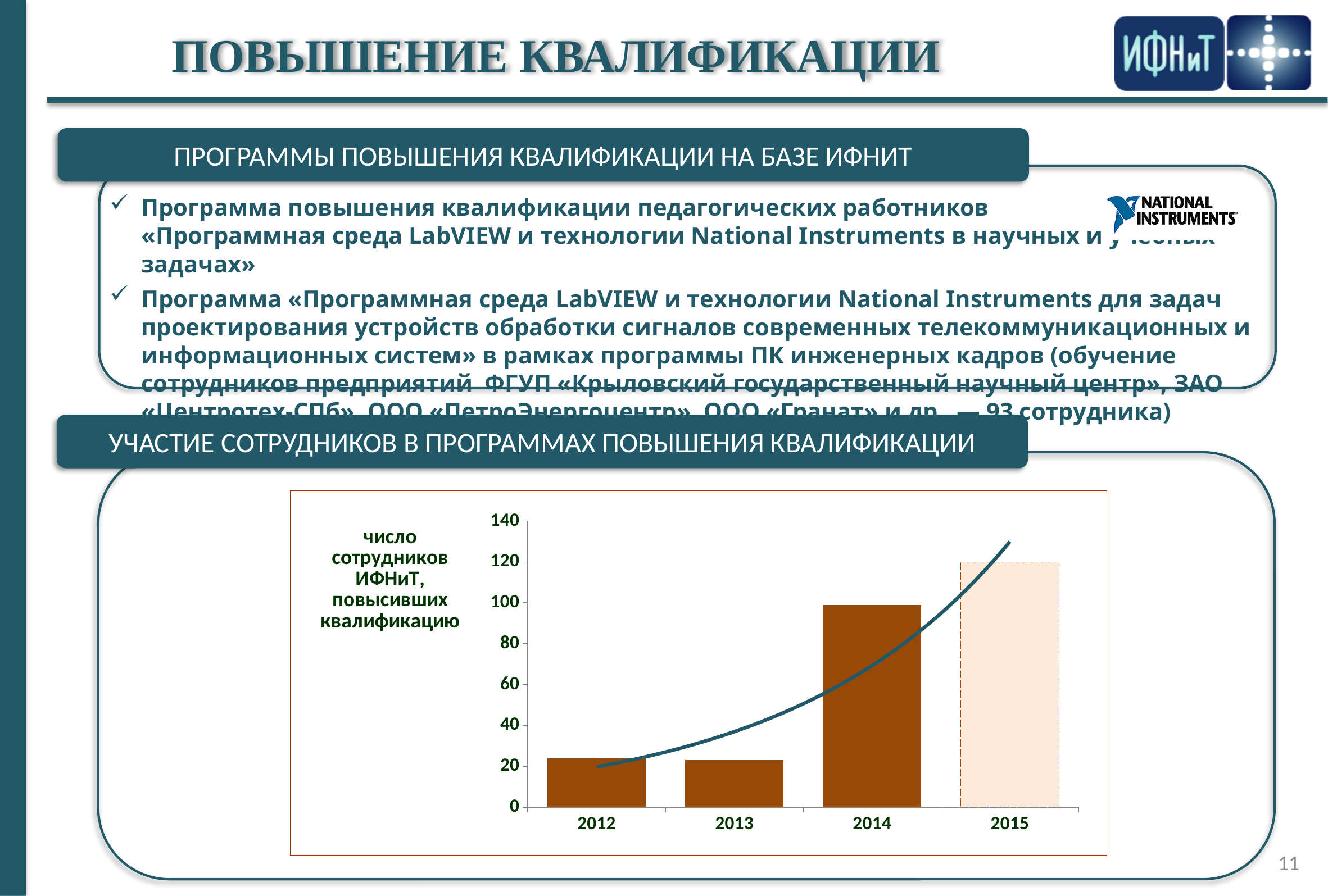
Is the bar for 2014 greater or less than 80? greater Do the values in the chart generally rise or fall from 2012 to 2015? rise Is the bar for 2012 greater or less than 40? less Which year has the highest bar in the chart? 2015 Which year has the larger bar, 2014 or 2015? 2015 Is the bar for 2015 greater or less than 100? greater Which year has the larger bar, 2013 or 2014? 2014 What kind of chart is shown on the slide? bar chart What does the chart's label say is being counted? число сотрудников ИФНиТ, повысивших квалификацию How many years are shown on the x axis of the chart? 4 What is the highest value shown on the vertical axis of the chart? 140